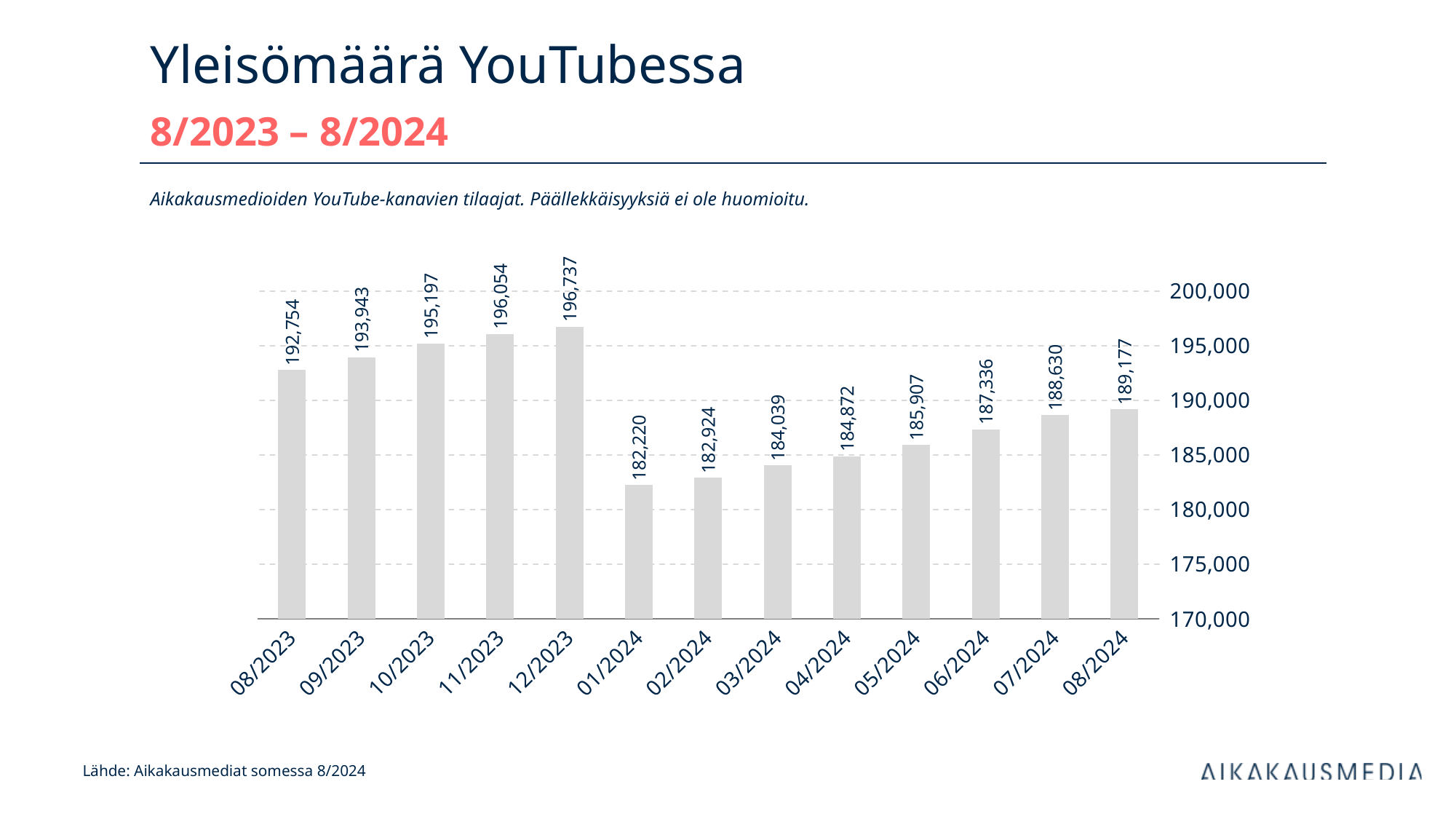
What is the value for 08/2024? 189,177 Which month has the highest value? 12/2023 What is the difference between the values for 12/2023 and 01/2024? 14,517 What is the difference between the values for 08/2024 and 08/2023? 3,577 Is the value for 05/2024 greater or less than 190,000? less What is the value for 01/2024? 182,220 Do the values rise or fall from 01/2024 to 08/2024? rise Which is larger, the value for 11/2023 or the value for 07/2024? 11/2023 What is the value for 12/2023? 196,737 Which month has the lowest value? 01/2024 What kind of chart is shown on the slide? bar chart How many months are shown on the x axis? 13